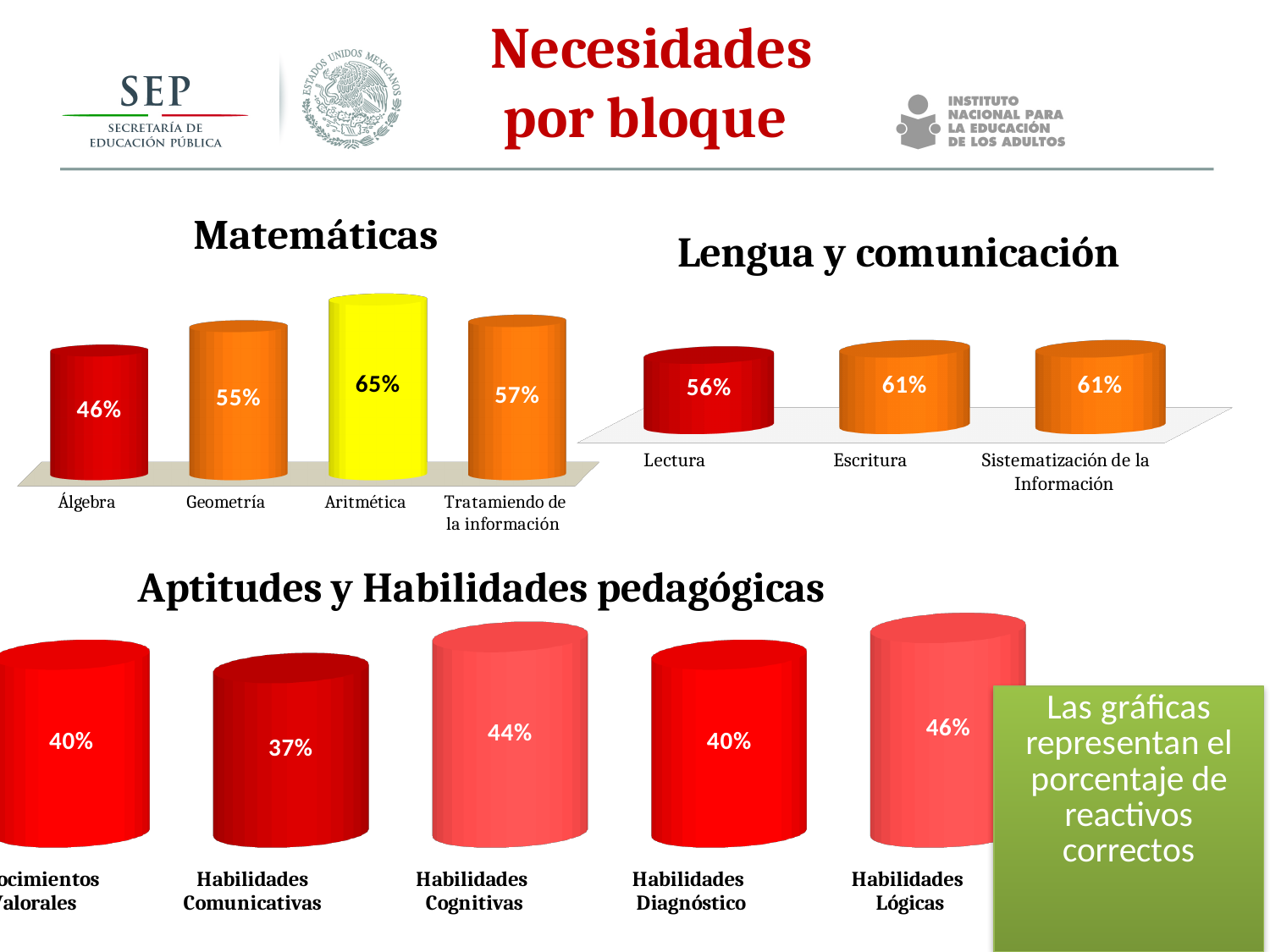
What kind of chart is the Matemáticas chart? Bar chart In the Matemáticas chart, what is the value for Aritmética? 65% In the Matemáticas chart, which category has the lowest value? Álgebra In the Lengua y comunicación chart, what is the value for Lectura? 56% In the Aptitudes y Habilidades pedagógicas chart, which category has the highest value? Habilidades Lógicas In the Lengua y comunicación chart, which category has the lowest value? Lectura In the Matemáticas chart, how many categories are shown? 4 In the Matemáticas chart, which bar is coloured yellow? Aritmética In the Lengua y comunicación chart, what is the difference between Escritura and Lectura? 5% In the Aptitudes y Habilidades pedagógicas chart, which is larger, Habilidades Cognitivas or Habilidades Diagnóstico? Habilidades Cognitivas In the Aptitudes y Habilidades pedagógicas chart, what is the value for Habilidades Comunicativas? 37% In the Matemáticas chart, what is the difference between Aritmética and Álgebra? 19%